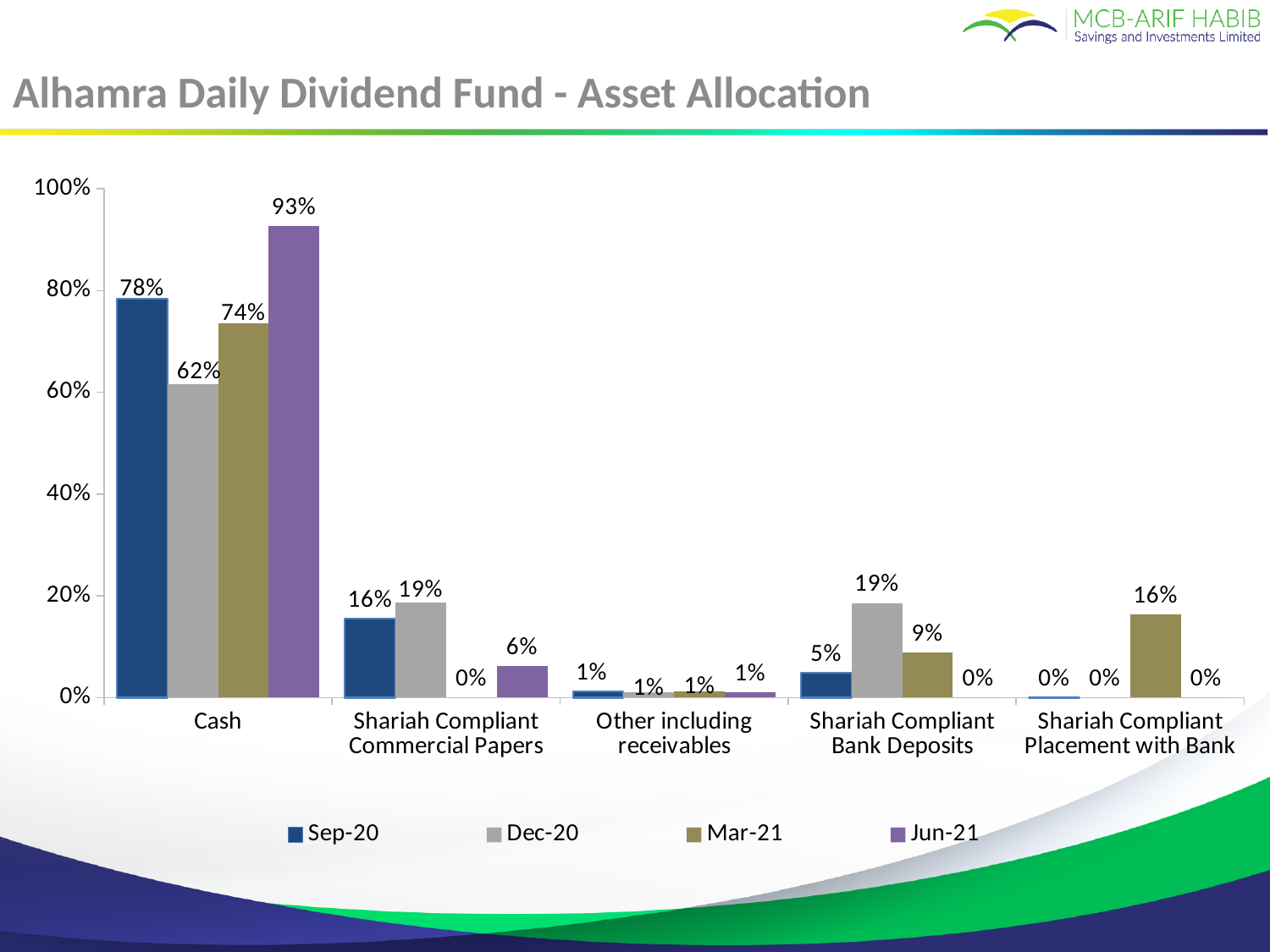
What is the title of the chart? Alhamra Daily Dividend Fund - Asset Allocation Which period has the highest Cash allocation? Jun-21 Which is larger for Shariah Compliant Bank Deposits: the Sep-20 value or the Mar-21 value? Mar-21 What type of chart is shown on the slide? Bar chart What is the Dec-20 value for Shariah Compliant Bank Deposits? 19% Which period has the lowest Cash allocation? Dec-20 What is the Mar-21 value for Shariah Compliant Placement with Bank? 16% What is the difference between the Jun-21 and Dec-20 Cash allocations? 31% What is the Cash allocation for Jun-21? 93% What is the Sep-20 value for Shariah Compliant Commercial Papers? 16% How many series does the legend list? 4 How many asset categories are shown on the x axis? 5